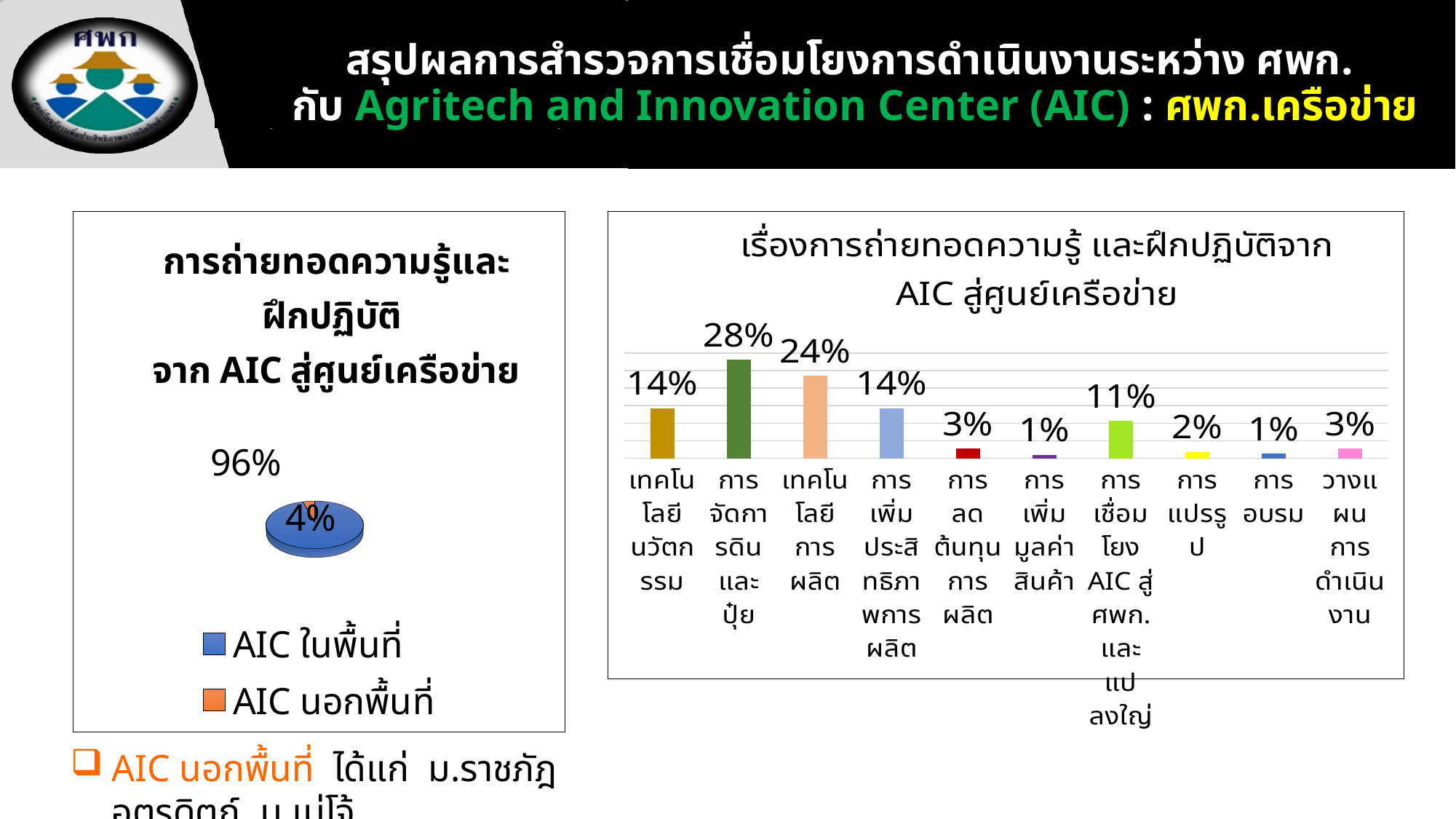
In the bar chart on the right, which is larger: the value for เทคโนโลยีนวัตกรรม or the value for การเชื่อมโยง AIC สู่ ศพก. และแปลงใหญ่? เทคโนโลยีนวัตกรรม In the bar chart on the right, what is the difference between the values for การจัดการดินและปุ๋ย and เทคโนโลยีการผลิต? 4% What kind of chart is the chart on the right of the slide? Bar chart How many entries does the legend of the pie chart on the left list? 2 In the bar chart on the right, what is the value for เทคโนโลยีการผลิต? 24% In the bar chart on the right, how many categories are shown? 10 What kind of chart is the chart on the left of the slide? Pie chart In the bar chart on the right, which category has the highest value? การจัดการดินและปุ๋ย In the pie chart on the left, what share is labelled for AIC ในพื้นที่? 96% In the bar chart on the right, what is the value for การเชื่อมโยง AIC สู่ ศพก. และแปลงใหญ่? 11% In the bar chart on the right, what is the value for การจัดการดินและปุ๋ย? 28% In the pie chart on the left, what share is labelled for AIC นอกพื้นที่? 4%